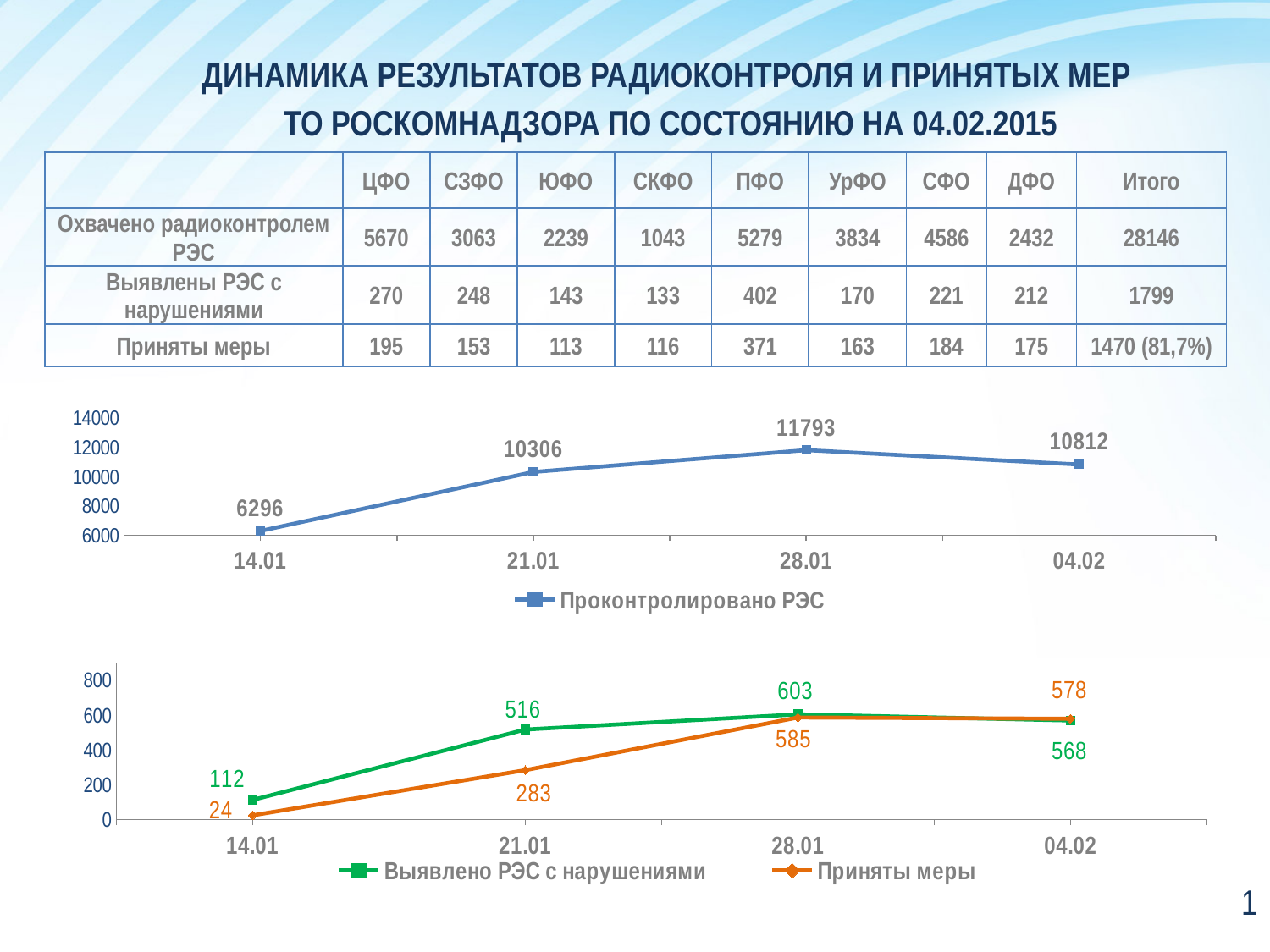
In the top chart (Проконтролировано РЭС), how many data points are plotted? 4 In the bottom chart, how many series does the legend list? 2 In the top chart (Проконтролировано РЭС), which date has the lowest value? 14.01 In the bottom chart, what is the value of Выявлено РЭС с нарушениями for 28.01? 603 What type of chart is the top chart (Проконтролировано РЭС)? line chart In the top chart (Проконтролировано РЭС), which date has the highest value? 28.01 In the bottom chart, what is the value of Приняты меры for 21.01? 283 In the bottom chart, which is larger for 04.02: Выявлено РЭС с нарушениями or Приняты меры? Приняты меры In the top chart (Проконтролировано РЭС), what is the value for 21.01? 10306 In the top chart (Проконтролировано РЭС), what is the difference between the values for 28.01 and 04.02? 981 In the bottom chart, does the Приняты меры series rise or fall from 14.01 to 28.01? rise In the bottom chart, what is the difference between Выявлено РЭС с нарушениями and Приняты меры for 14.01? 88